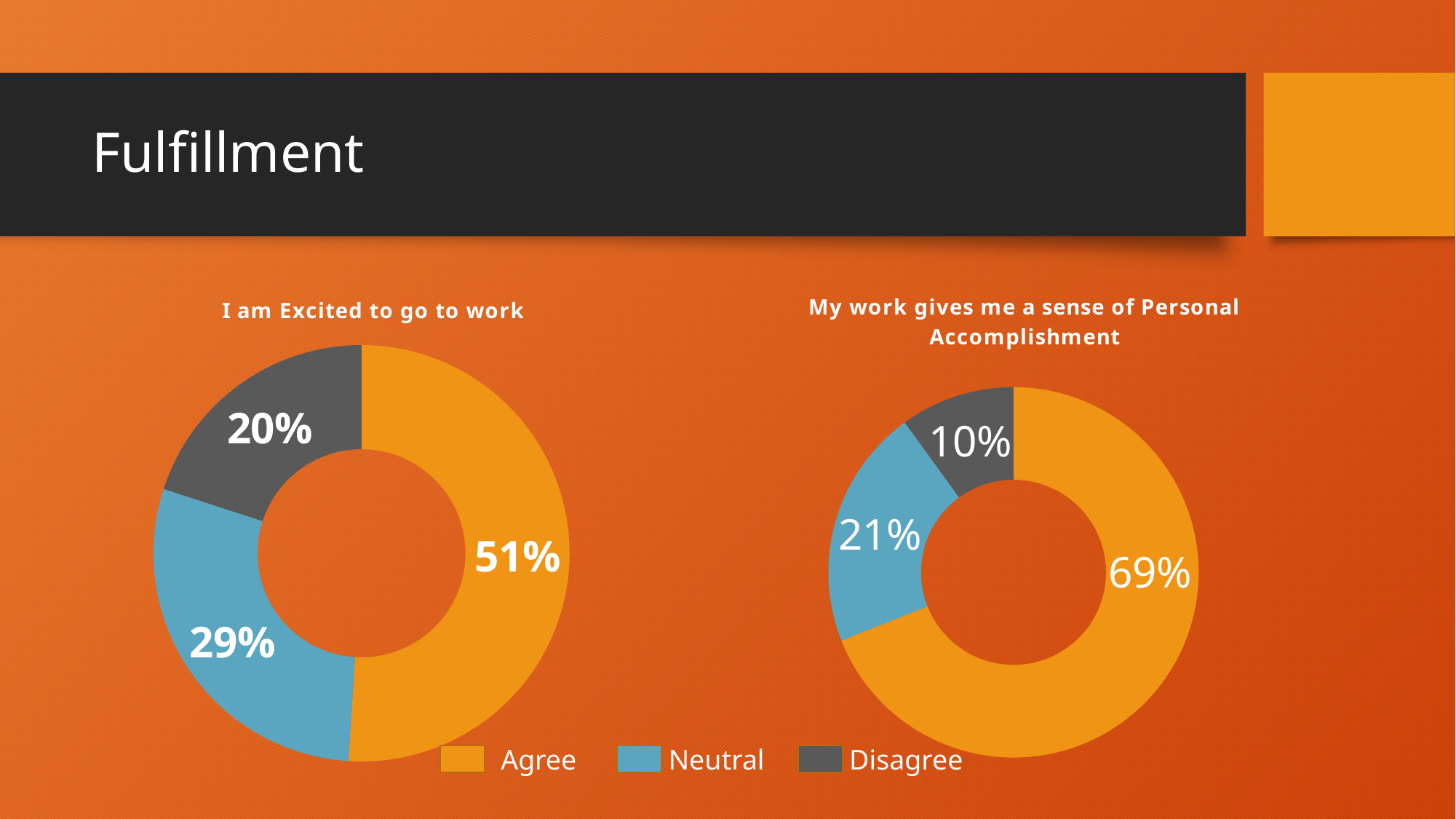
In the 'My work gives me a sense of Personal Accomplishment' chart, what percentage is shown for Agree? 69% In the 'My work gives me a sense of Personal Accomplishment' chart, what percentage is shown for Disagree? 10% In the 'I am Excited to go to work' chart, which category has the largest share? Agree Which chart shows a higher Agree percentage, 'I am Excited to go to work' or 'My work gives me a sense of Personal Accomplishment'? My work gives me a sense of Personal Accomplishment In the 'I am Excited to go to work' chart, what percentage is shown for Disagree? 20% In the 'I am Excited to go to work' chart, what percentage is shown for Neutral? 29% In the 'I am Excited to go to work' chart, what is the difference between the Neutral and Disagree percentages? 9% In the 'I am Excited to go to work' chart, what percentage is shown for Agree? 51% What type of chart is used for 'I am Excited to go to work'? Doughnut chart How many categories does the legend list? 3 In the 'My work gives me a sense of Personal Accomplishment' chart, which category has the smallest share? Disagree In the 'My work gives me a sense of Personal Accomplishment' chart, what percentage is shown for Neutral? 21%